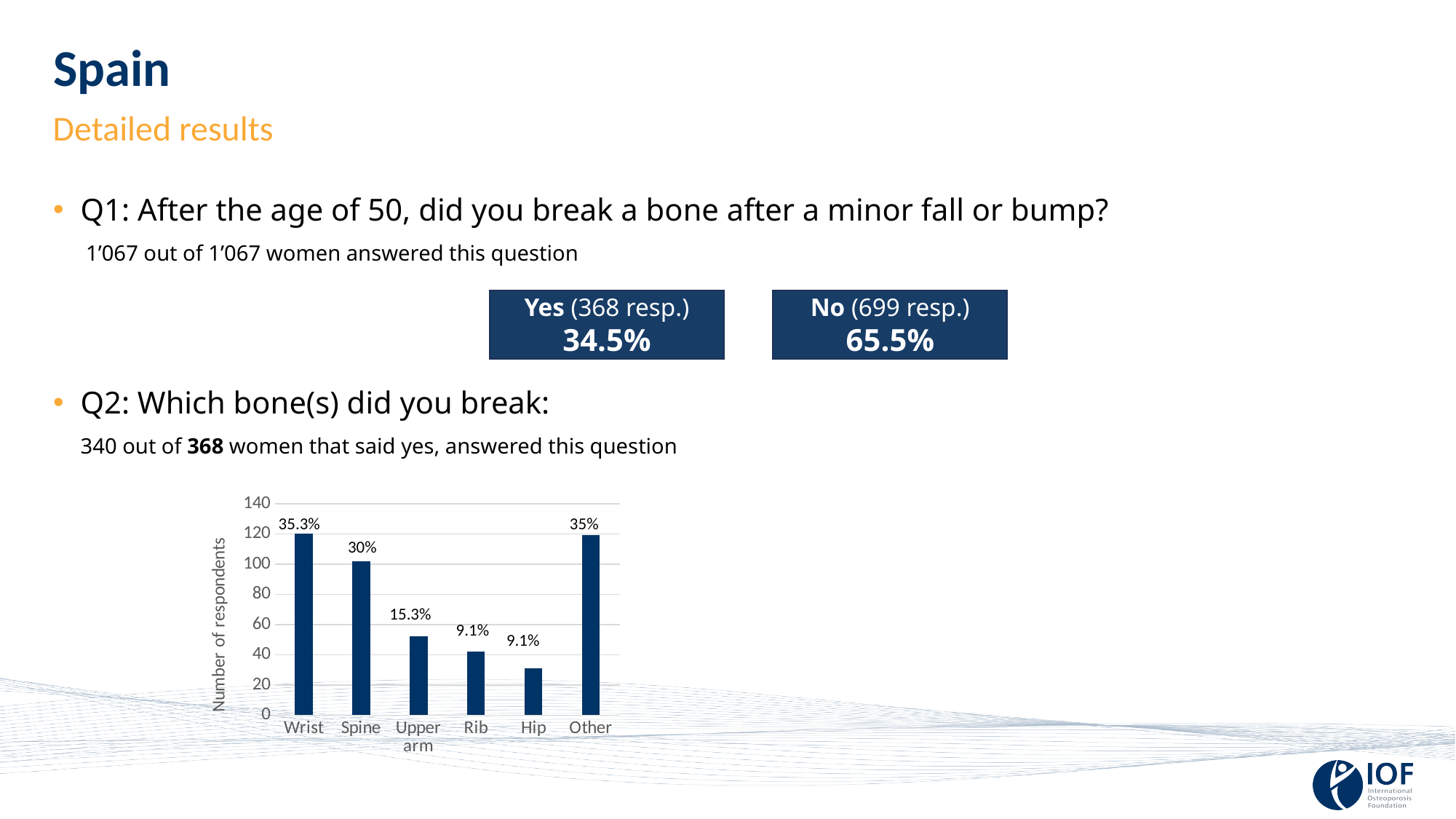
How many bone categories are shown on the x axis of the chart? 6 What kind of chart is shown on the slide? bar chart What percentage label is shown for Wrist in the chart? 35.3% What percentage label is shown for Hip in the chart? 9.1% Is the number of respondents for Hip greater or less than 40? less What is the difference in percentage points between the Wrist label and the Spine label? 5.3 What percentage label is shown for Spine in the chart? 30% What percentage label is shown for Upper arm in the chart? 15.3% What percentage label is shown for Other in the chart? 35% What is the title of the vertical axis of the chart? Number of respondents Which is larger in the chart, the value for Spine or the value for Upper arm? Spine Which category has the highest percentage label in the chart? Wrist